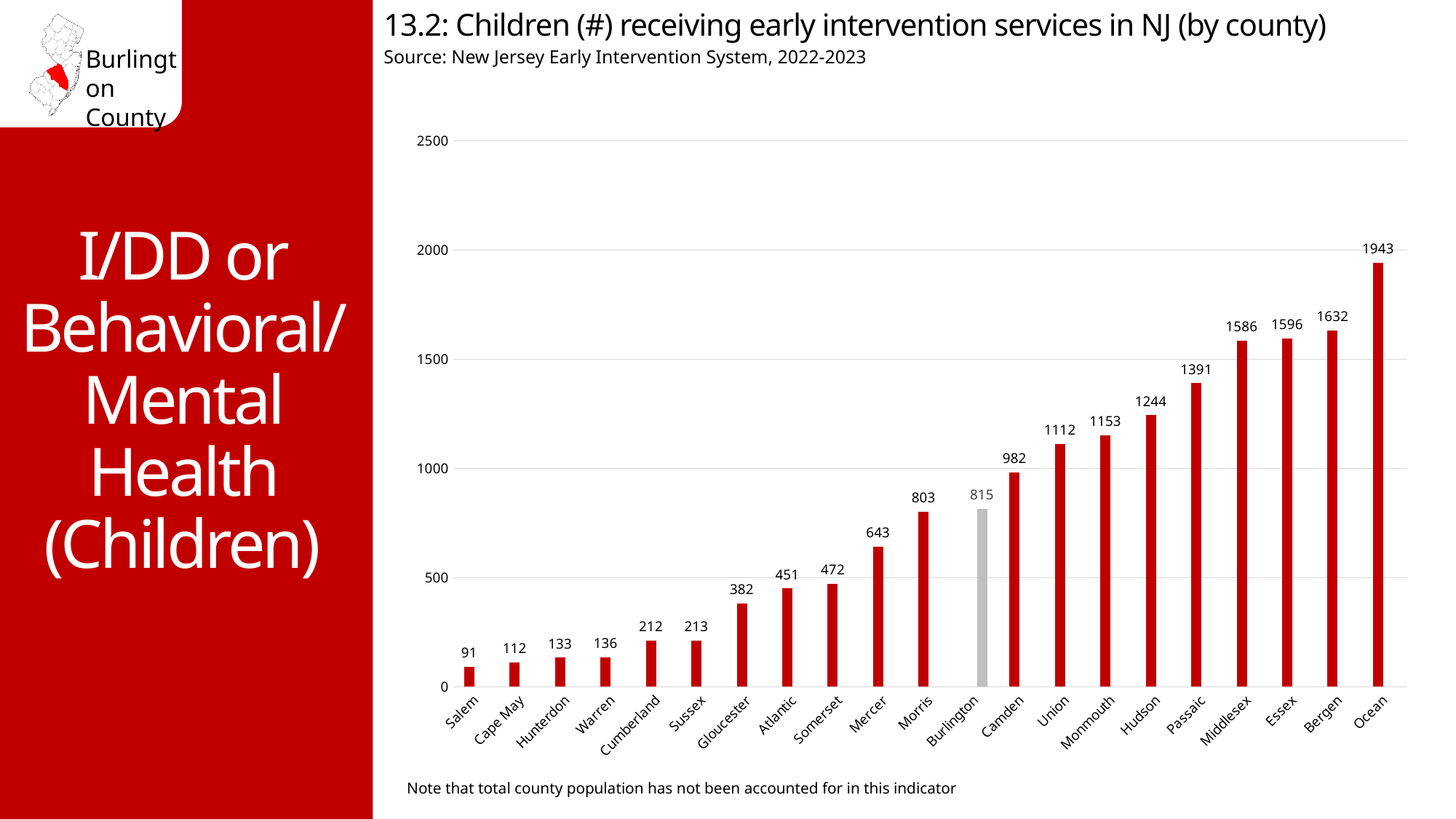
Which county has the lowest number of children receiving early intervention services? Salem Which county has the highest number of children receiving early intervention services? Ocean What kind of chart is shown on the slide? Bar chart Which county's bar is shown in grey rather than red? Burlington What is the value shown for Hudson County? 1244 What is the difference between the values for Burlington and Camden? 167 What is the difference between the values for Ocean and Bergen? 311 Is the value for Passaic greater or less than 1500? less Which county has a larger value, Mercer or Morris? Morris What is the value shown for Ocean County? 1943 How many children are receiving early intervention services in Burlington County? 815 How many counties are shown on the chart? 21